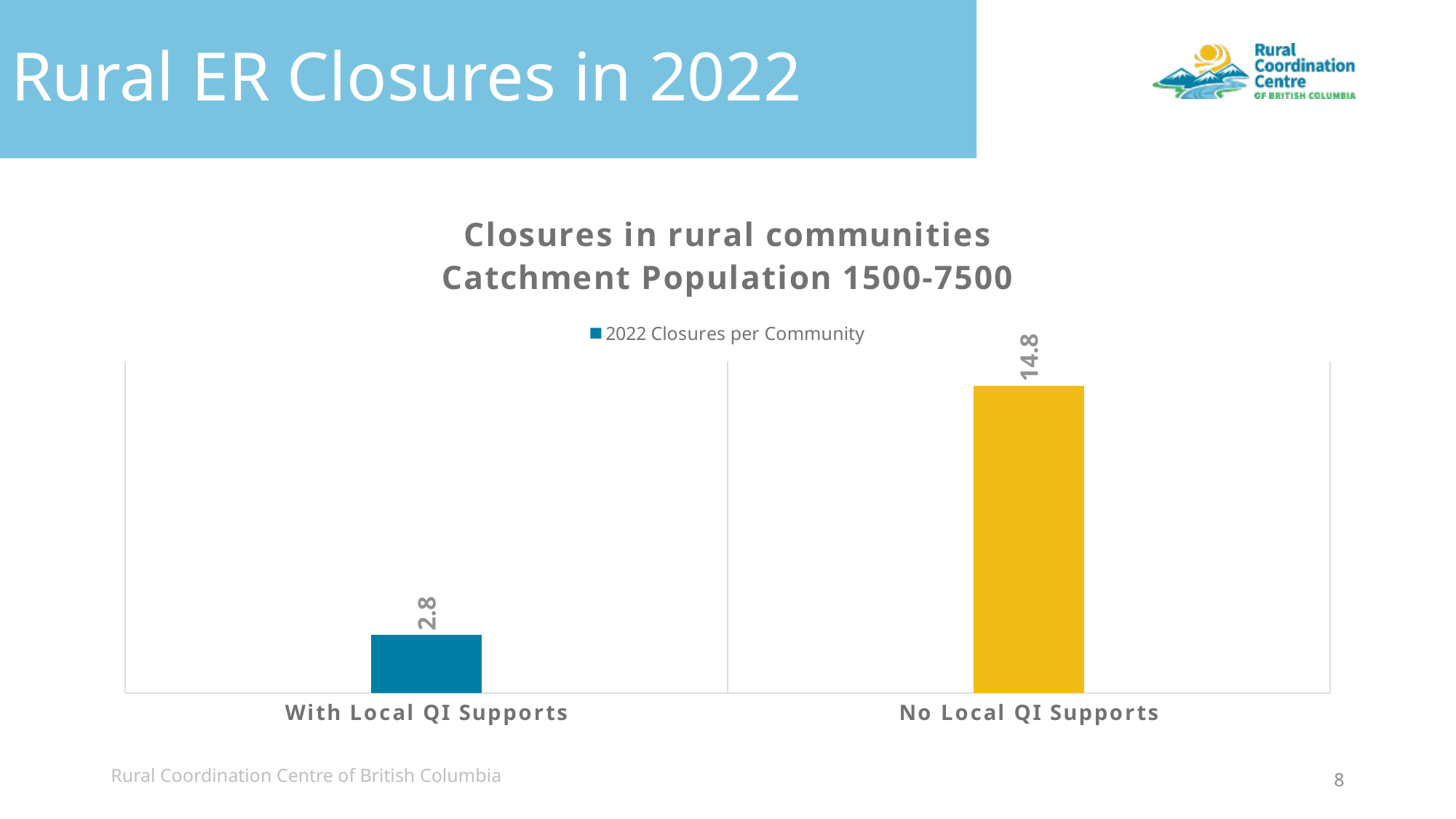
How many categories are shown on the chart? 2 How many series does the legend list? 1 What is the title of the chart? Closures in rural communities Catchment Population 1500-7500 What is the value for With Local QI Supports? 2.8 What is the difference between the values for No Local QI Supports and With Local QI Supports? 12.0 What is the value for No Local QI Supports? 14.8 What series name is listed in the chart legend? 2022 Closures per Community What kind of chart is shown on the slide? Bar chart Which is larger, the value for With Local QI Supports or the value for No Local QI Supports? No Local QI Supports Which category has the lowest value? With Local QI Supports Which category has the highest value? No Local QI Supports